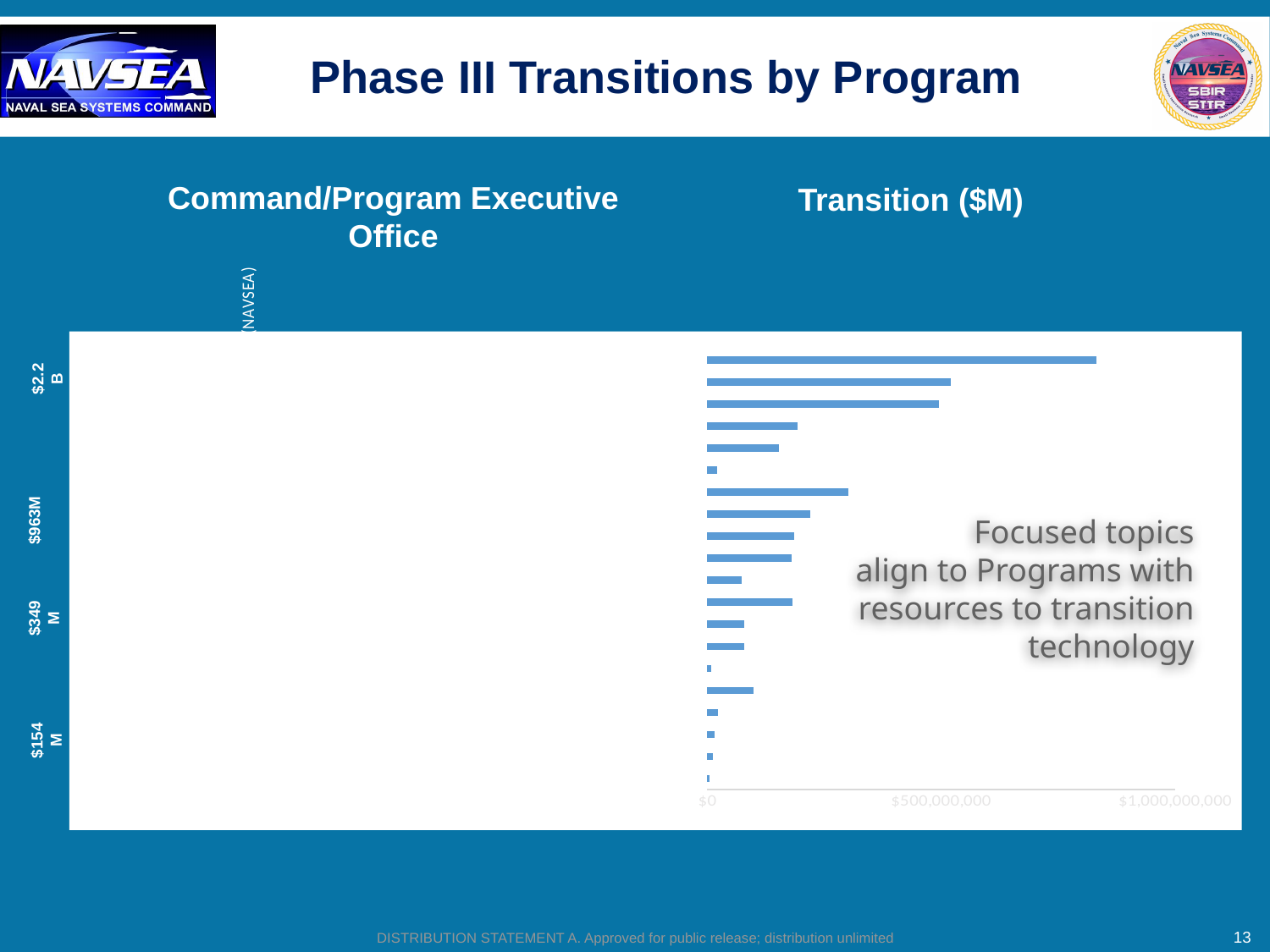
What is the highest value labelled on the chart's x axis? $1,000,000,000 Do the bar values generally increase or decrease going from the top of the chart to the bottom? decrease What is the title of the chart on the right side of the slide? Transition ($M) Is the value of the fourth bar from the top greater or less than $500,000,000? less Which is larger, the topmost bar or the second bar from the top? the topmost bar How many bars are plotted in the chart? 20 Is the value of the topmost bar greater or less than $1,000,000,000? less Is the value of the topmost bar greater or less than $500,000,000? greater Which bar in the chart is the longest? the topmost bar What kind of chart is shown on the slide? bar chart